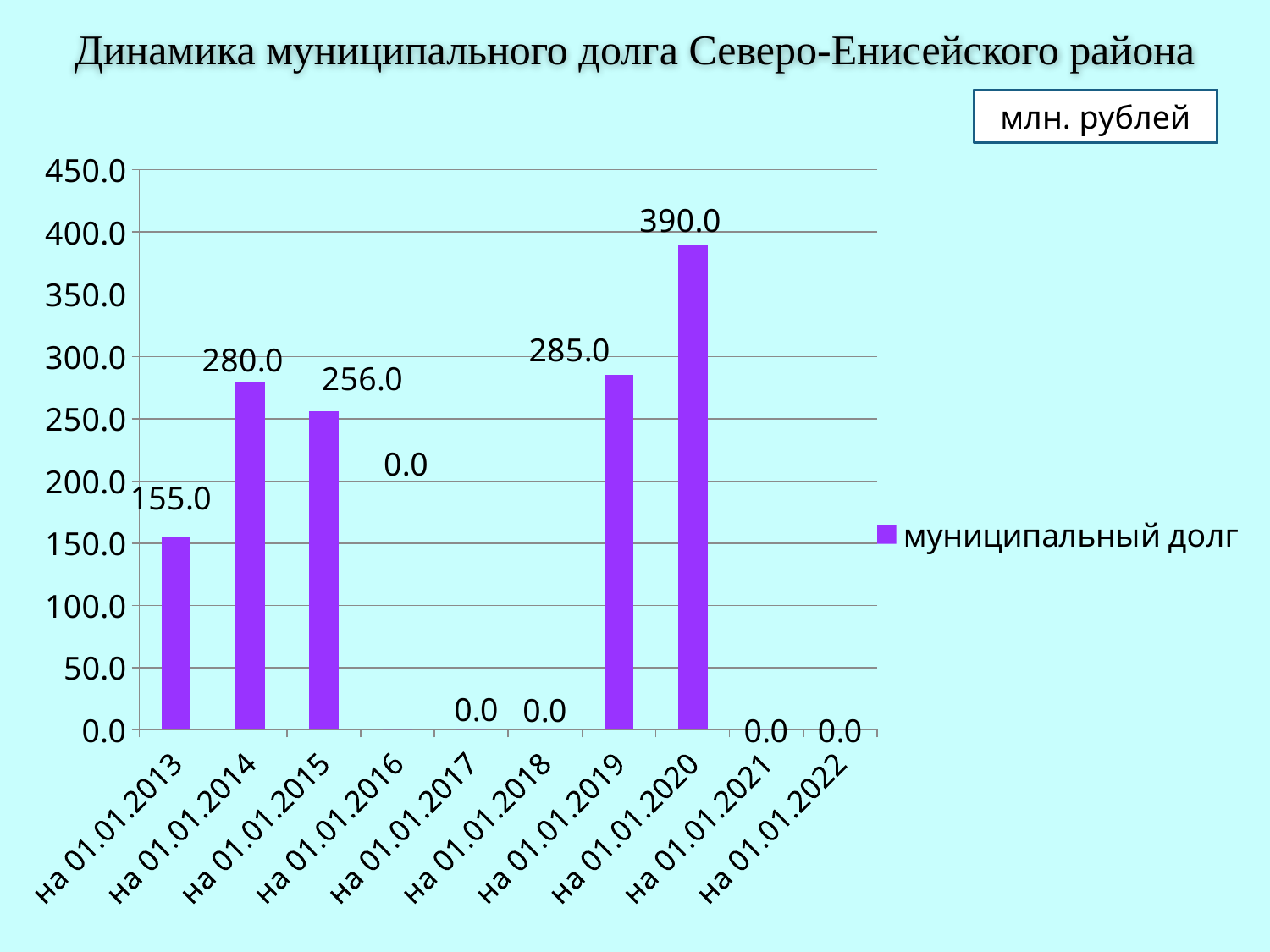
What unit is indicated in the box at the top right of the slide? млн. рублей Which category has the highest value? на 01.01.2020 What is the value for на 01.01.2020? 390.0 How many categories are shown on the x axis? 10 What is the value for на 01.01.2013? 155.0 How many series does the legend list? 1 What kind of chart is shown on the slide? bar chart Which is larger, the value for на 01.01.2014 or the value for на 01.01.2015? на 01.01.2014 What is the difference between the values for на 01.01.2014 and на 01.01.2013? 125.0 What is the value for на 01.01.2015? 256.0 What is the difference between the values for на 01.01.2020 and на 01.01.2019? 105.0 What is the value for на 01.01.2019? 285.0